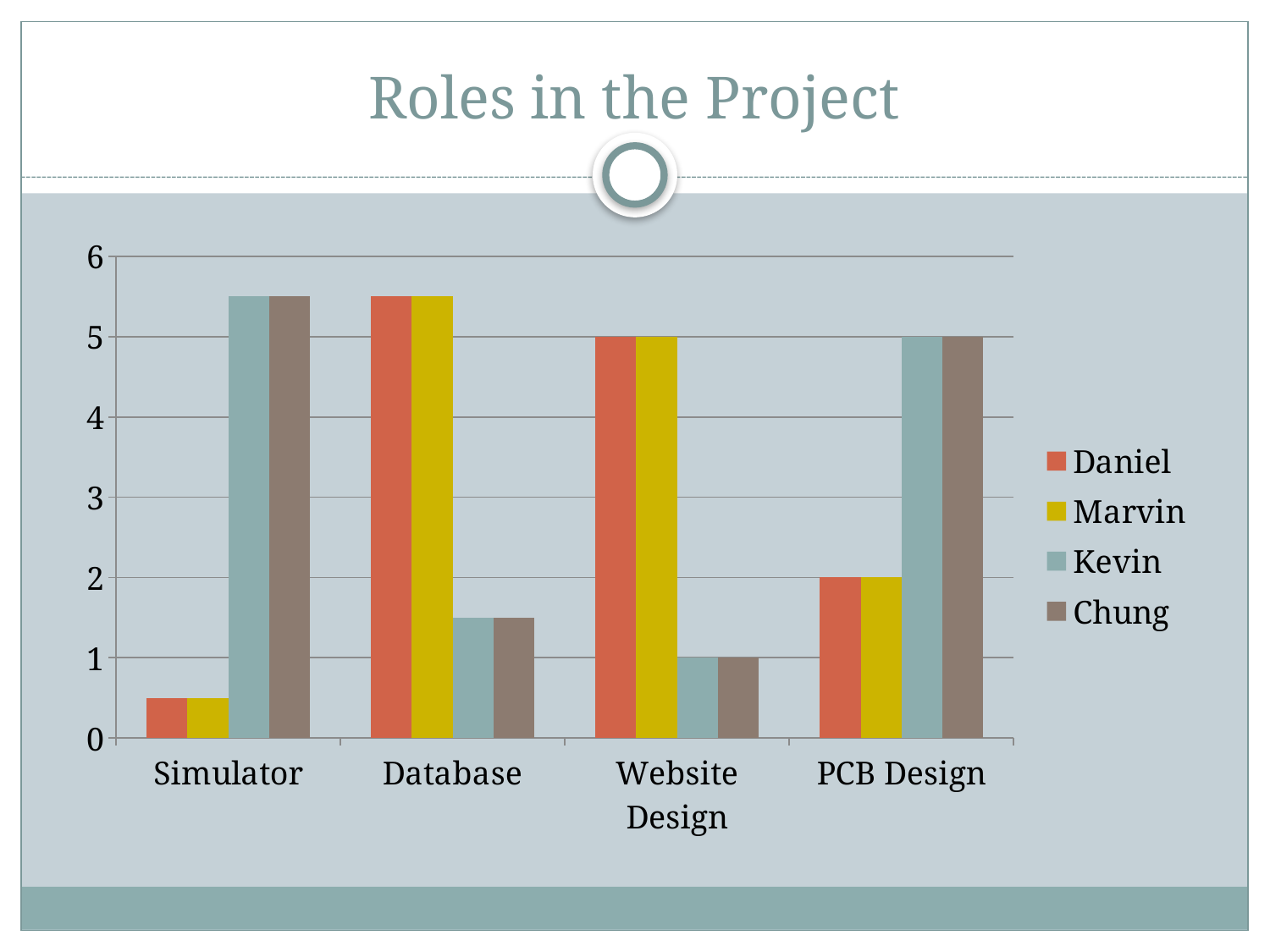
In which category is Kevin's value lowest? Website Design What is the value for Daniel in Website Design? 5 How many series does the legend list? 4 What is the title of the slide? Roles in the Project What is the value for Chung in PCB Design? 5 Is the value for Daniel in Simulator greater or less than 1? less Is the value for Kevin in Simulator greater or less than 5? greater What kind of chart is shown on the slide? bar chart What is the value for Daniel in PCB Design? 2 What is the value for Kevin in Website Design? 1 Which is larger in Database: the value for Marvin or the value for Chung? Marvin How many categories are shown on the x axis? 4